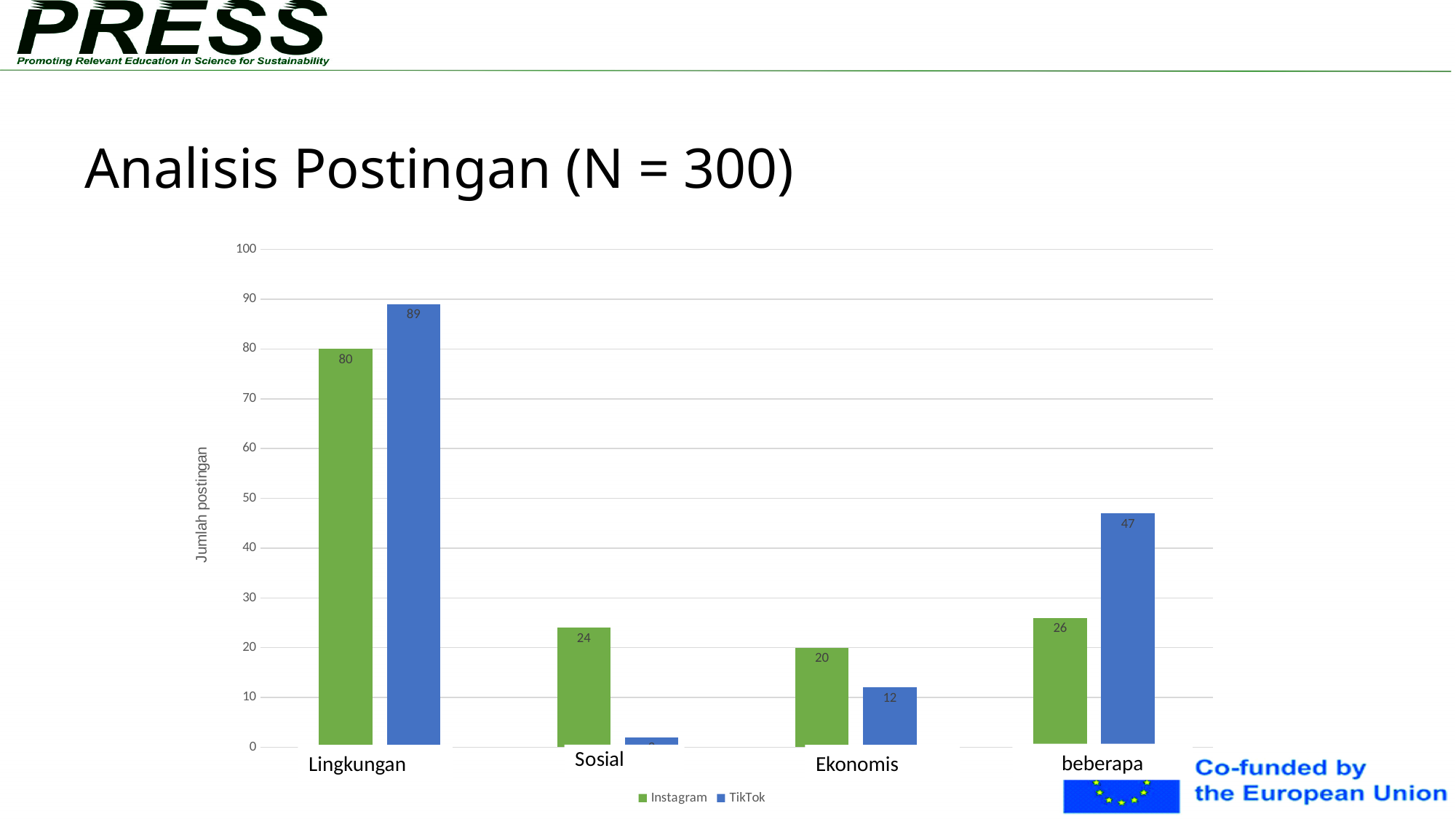
What is the Instagram value for Lingkungan? 80 How many categories are shown on the x axis? 4 Which is larger for beberapa, the Instagram value or the TikTok value? TikTok What is the difference between the TikTok and Instagram values for Lingkungan? 9 Which category has the lowest Instagram value? Ekonomis Which category has the highest TikTok value? Lingkungan What kind of chart is shown on the slide? bar chart How many series does the legend list? 2 What is the TikTok value for Ekonomis? 12 Is the TikTok value for Sosial greater or less than 10? less What is the TikTok value for beberapa? 47 What is the Instagram value for Ekonomis? 20